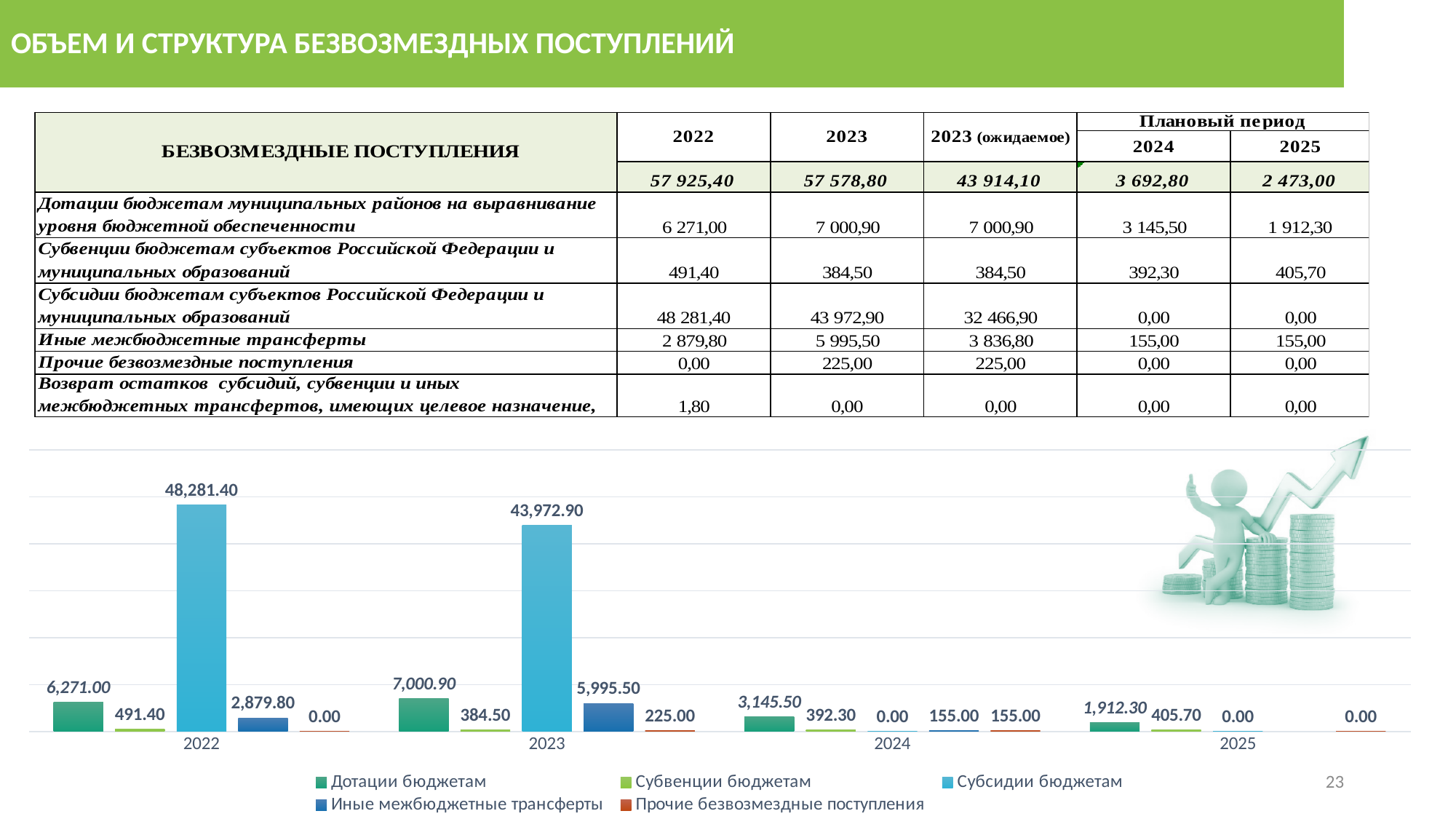
In the bar chart, what is the value of Дотации бюджетам for 2023? 7,000.90 In the bar chart, what is the value of Субвенции бюджетам for 2025? 405.70 How many series does the legend of the bar chart list? 5 In the bar chart, what is the value of Иные межбюджетные трансферты for 2023? 5,995.50 In the bar chart, which year has the lowest value for Дотации бюджетам? 2025 In the bar chart, which is larger: Иные межбюджетные трансферты in 2022 or in 2023? 2023 In the bar chart, which year has the highest value for Субсидии бюджетам? 2022 How many year categories are shown on the x axis of the bar chart? 4 In the bar chart, do the values for Дотации бюджетам rise or fall from 2023 to 2025? fall In the bar chart, what is the difference between Субсидии бюджетам in 2022 and in 2023? 4,308.50 In the bar chart, what is the value of Субсидии бюджетам for 2022? 48,281.40 What type of chart is shown at the bottom of the slide? bar chart